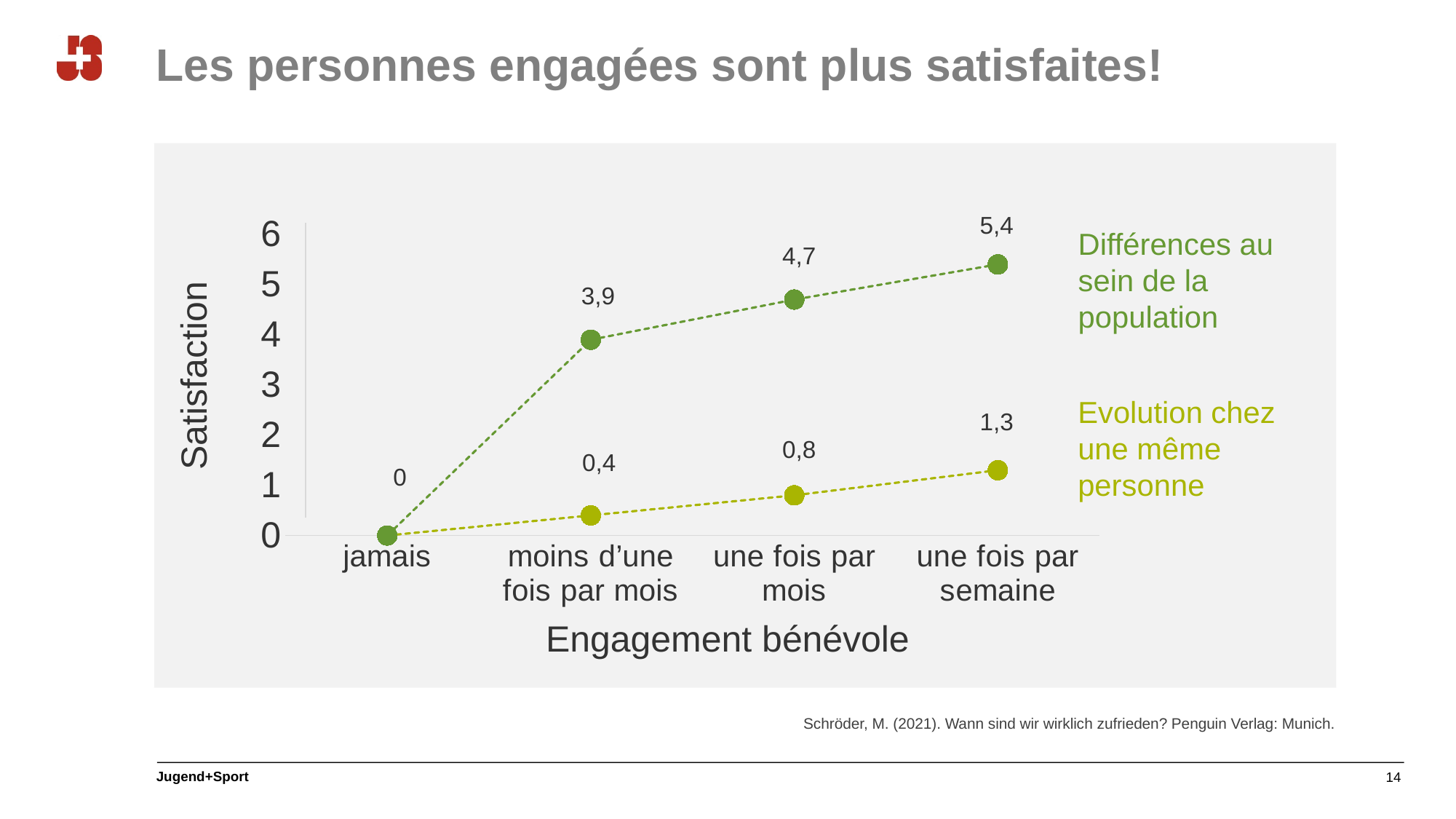
What is the difference between the 'Différences au sein de la population' and 'Evolution chez une même personne' values for 'une fois par semaine'? 4,1 Which category has the lowest value in the 'Evolution chez une même personne' series? jamais Which category has the highest value in the 'Différences au sein de la population' series? une fois par semaine Which is larger for 'une fois par mois': the 'Différences au sein de la population' value or the 'Evolution chez une même personne' value? Différences au sein de la population What is the value for 'une fois par semaine' in the 'Différences au sein de la population' series? 5,4 What is the value for 'moins d'une fois par mois' in the 'Différences au sein de la population' series? 3,9 How many series are plotted on the chart? 2 How many categories are shown on the x axis? 4 What is the value for 'une fois par mois' in the 'Evolution chez une même personne' series? 0,8 Do the values of the 'Evolution chez une même personne' series rise or fall from 'jamais' to 'une fois par semaine'? rise What is the label of the y axis? Satisfaction What kind of chart is shown on the slide? line chart